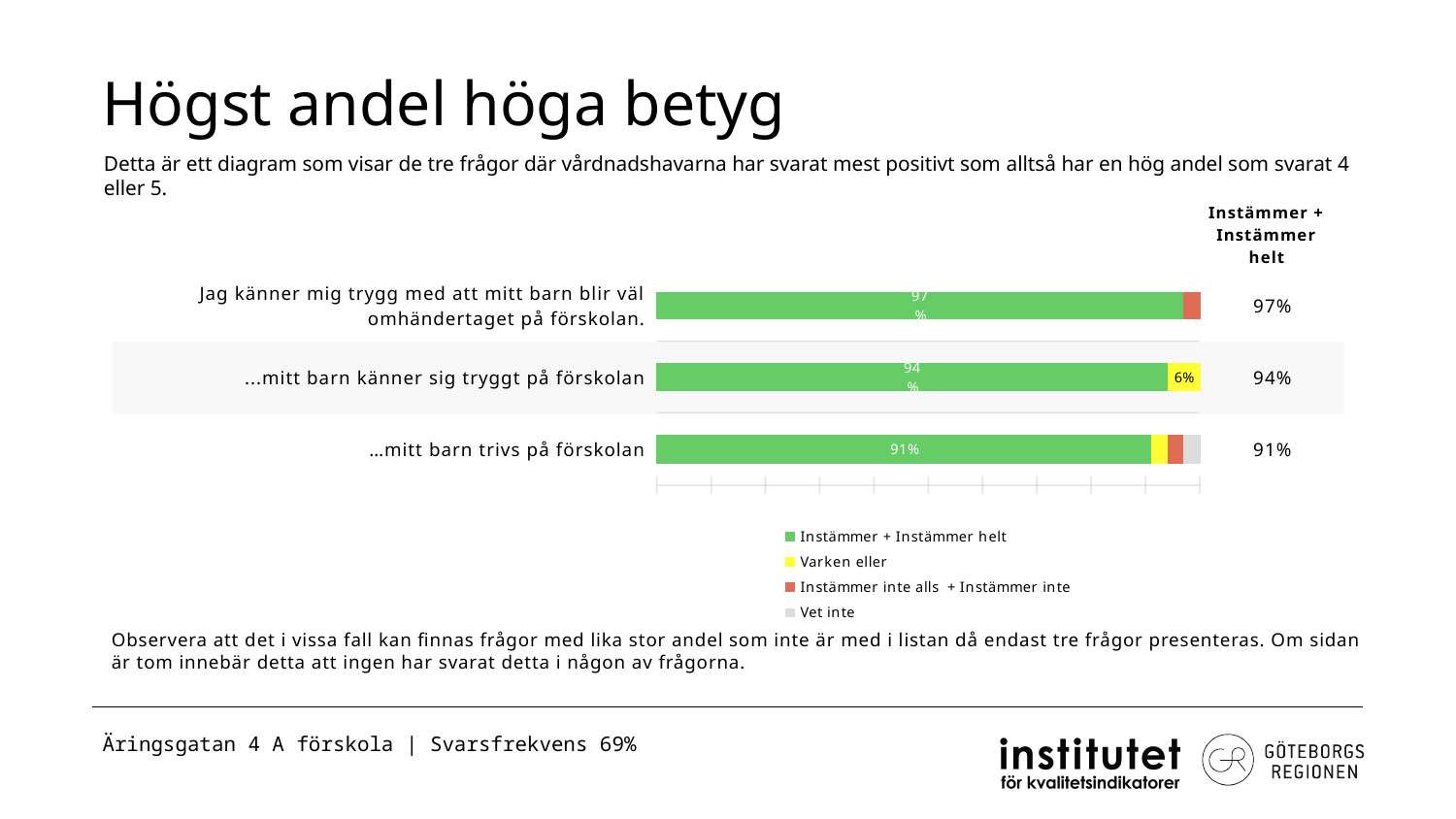
What is the 'Instämmer + Instämmer helt' share for '…mitt barn känner sig tryggt på förskolan'? 94% What is the 'Varken eller' share for '…mitt barn känner sig tryggt på förskolan'? 6% How many series does the legend list? 4 What is the difference in 'Instämmer + Instämmer helt' share between 'Jag känner mig trygg med att mitt barn blir väl omhändertaget på förskolan' and '…mitt barn trivs på förskolan'? 6% What is the 'Instämmer + Instämmer helt' share for '…mitt barn trivs på förskolan'? 91% How many questions (categories) are shown in the chart? 3 Which has a larger 'Instämmer + Instämmer helt' share: '…mitt barn känner sig tryggt på förskolan' or '…mitt barn trivs på förskolan'? …mitt barn känner sig tryggt på förskolan What kind of chart is shown on the slide? stacked bar chart Which question has the lowest 'Instämmer + Instämmer helt' share? …mitt barn trivs på förskolan Which question has the highest 'Instämmer + Instämmer helt' share? Jag känner mig trygg med att mitt barn blir väl omhändertaget på förskolan Which colour represents 'Vet inte' in the legend? grey What is the 'Instämmer + Instämmer helt' share for 'Jag känner mig trygg med att mitt barn blir väl omhändertaget på förskolan'? 97%